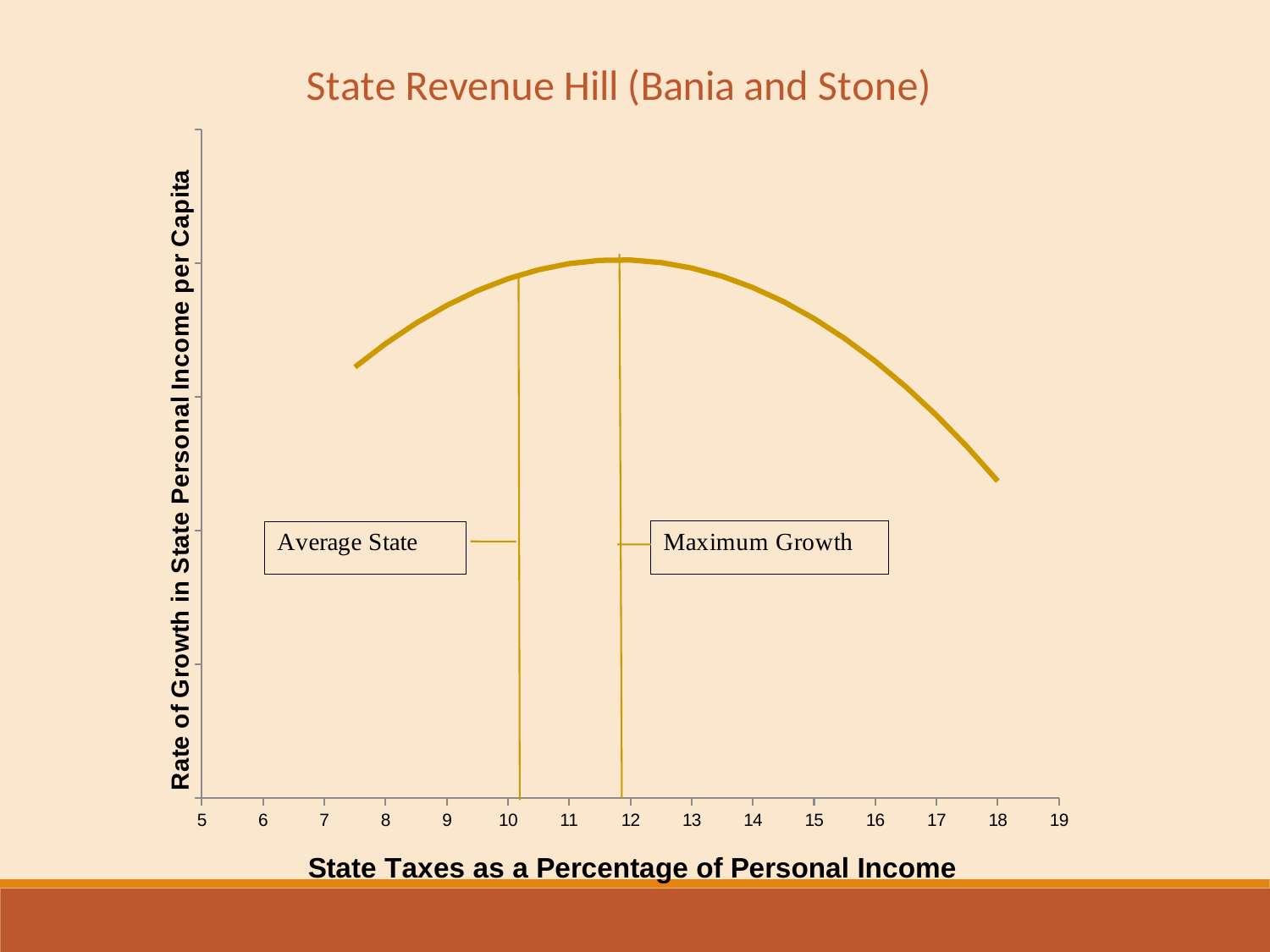
Which labelled vertical line is further to the right on the x axis, Average State or Maximum Growth? Maximum Growth What is the title of the chart? State Revenue Hill (Bania and Stone) Does the curve rise or fall as the x axis goes from 13 to 18? Fall Does the curve rise or fall as the x axis goes from 8 to 11? Rise What kind of chart is shown on the slide? Line chart What is the highest value shown on the x axis? 19 What is the lowest value shown on the x axis? 5 How many curves (data series) are plotted on the chart? 1 Is the x-axis position of the Maximum Growth line greater or less than 13? less Is the x-axis position of the Maximum Growth line greater or less than 11? greater Is the x-axis position of the Average State line greater or less than 9? greater What is the label of the x axis? State Taxes as a Percentage of Personal Income